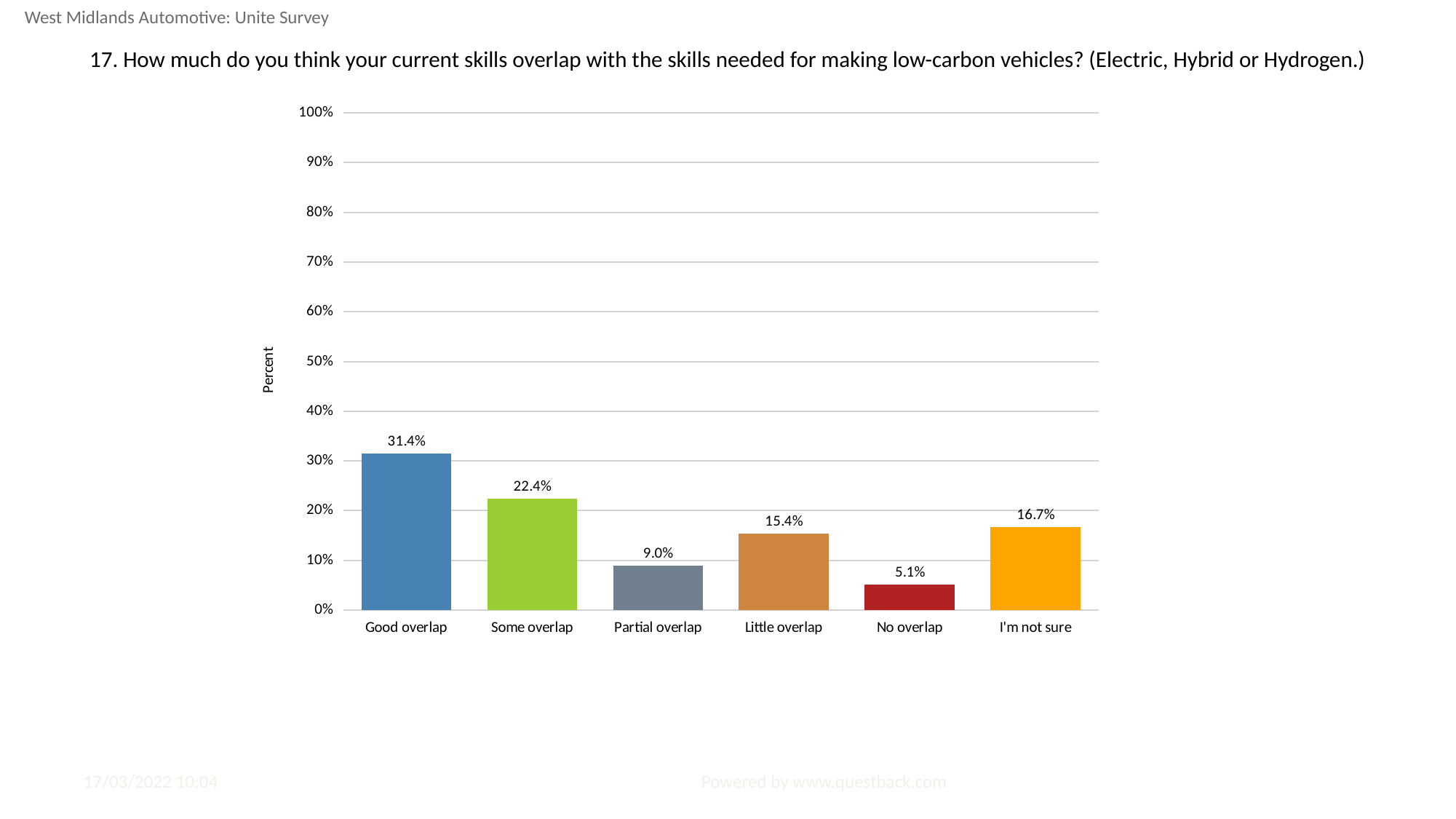
Is the value for 'Some overlap' greater or less than 20%? greater Which is larger, the value for 'Little overlap' or the value for 'I'm not sure'? I'm not sure What percentage of respondents answered 'I'm not sure'? 16.7% Which response category has the lowest percentage? No overlap What percentage of respondents said they have a good overlap of skills? 31.4% Which response category has the highest percentage? Good overlap How many response categories are shown on the x axis? 6 What is the label on the vertical axis of the chart? Percent What is the value shown for 'Partial overlap'? 9.0% What is the difference between 'Little overlap' and 'No overlap'? 10.3 percentage points What type of chart is shown on the slide? Bar chart What is the difference in percentage points between 'Good overlap' and 'Some overlap'? 9.0 percentage points